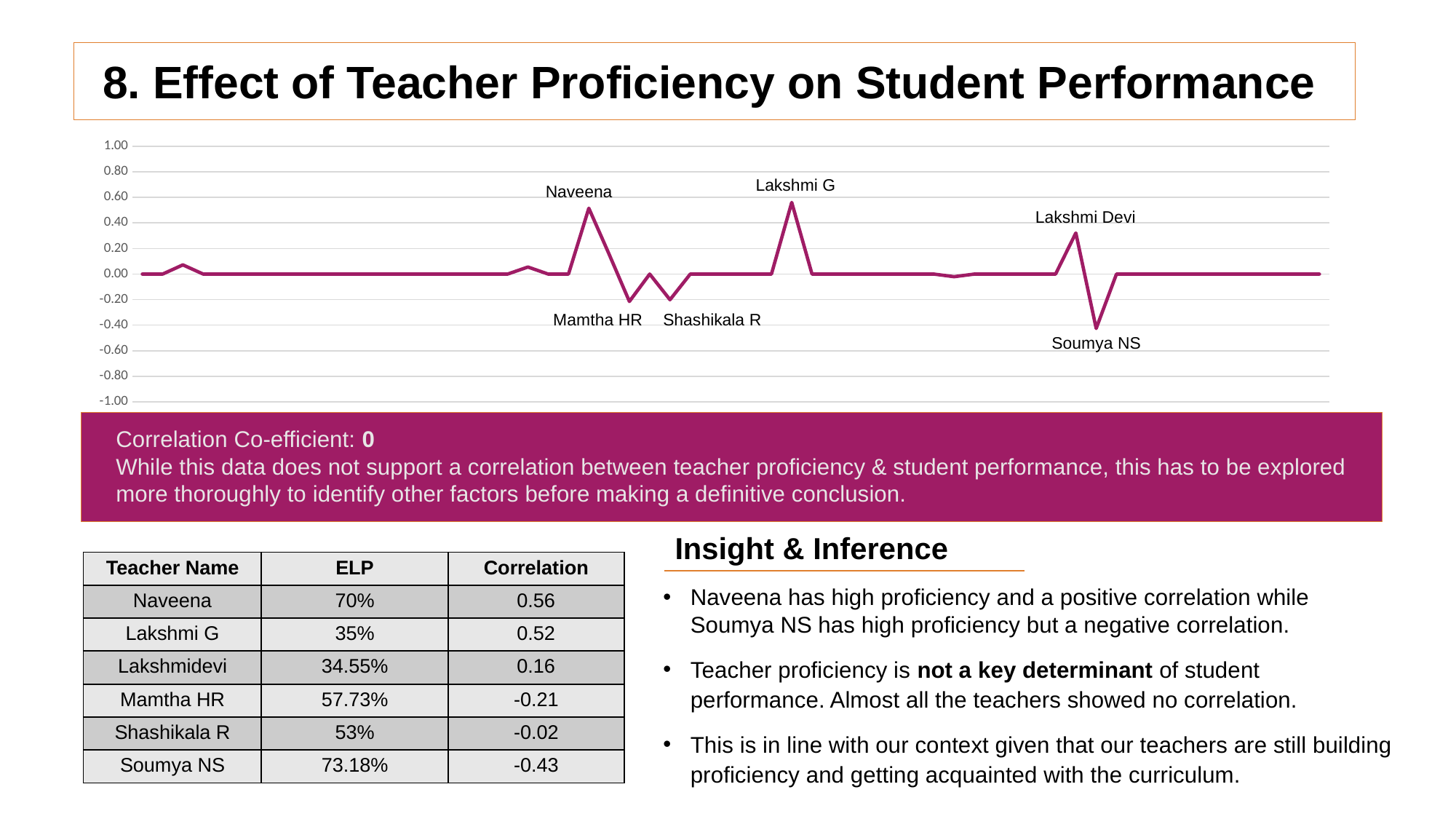
Is the value for Mamtha HR on the chart greater or less than 0.00? less Is the value for Soumya NS on the chart greater or less than -0.20? less What are the minimum and maximum values shown on the chart's vertical axis? -1.00 and 1.00 What kind of chart is shown on the slide? line chart Is the value for Lakshmi Devi on the chart greater or less than 0.20? greater Which labeled point on the chart has the lowest value? Soumya NS Which has the larger value on the chart, Naveena or Lakshmi Devi? Naveena How many points on the chart are labeled with a teacher's name? 6 Which has the lower value on the chart, Soumya NS or Mamtha HR? Soumya NS